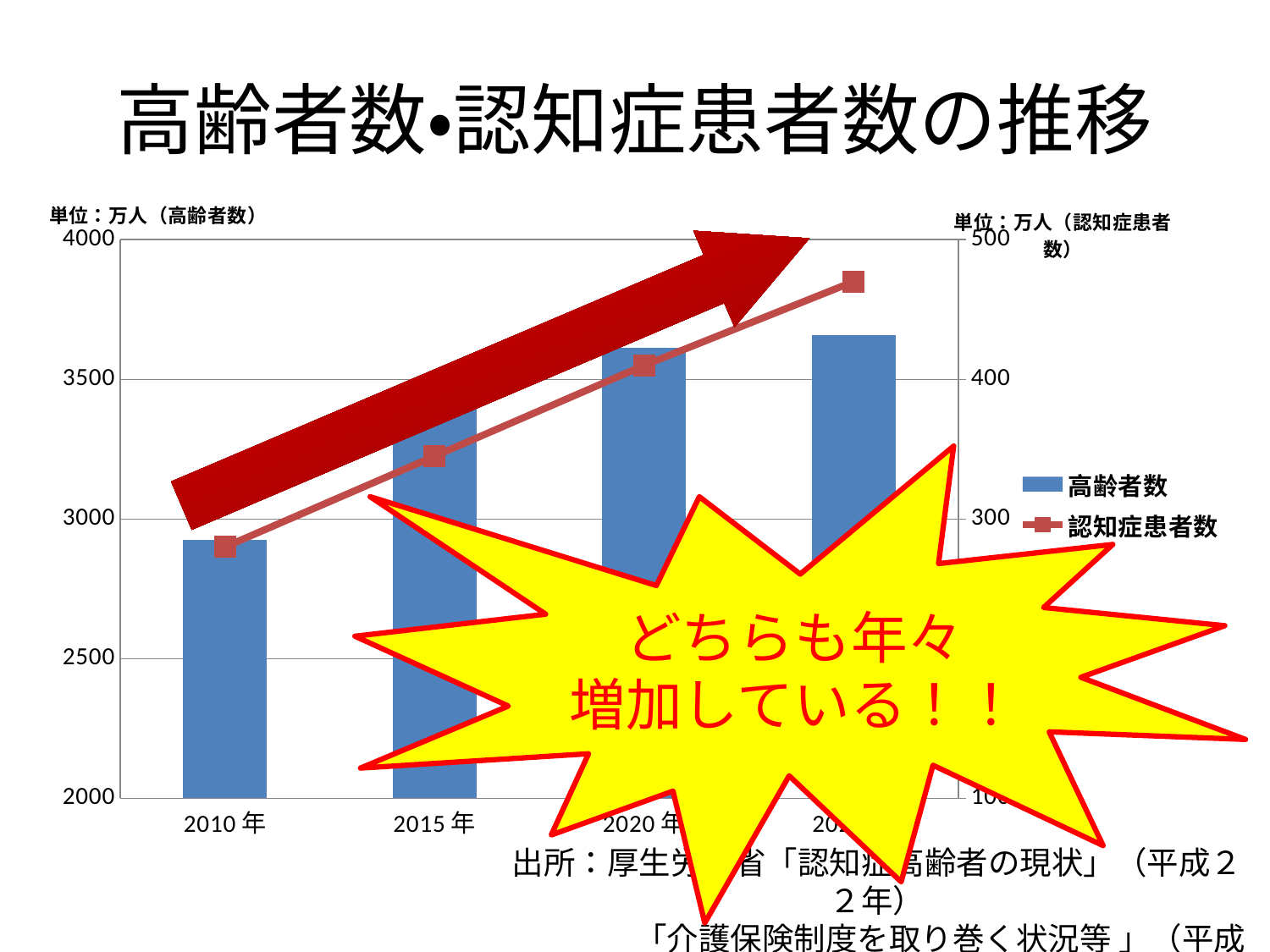
How many bars are plotted in the chart? 4 Is the 認知症患者数 value for 2010年 greater or less than 300 on the right axis? less Is the 認知症患者数 value for 2015年 greater or less than 300 on the right axis? greater What are the two series named in the legend? 高齢者数 and 認知症患者数 Is the 高齢者数 value for 2020年 greater or less than 3500? greater How many series does the legend list? 2 What is the title of the chart on the slide? 高齢者数•認知症患者数の推移 Do the 認知症患者数 values rise or fall from 2010年 onward along the x axis? rise Which year has the lowest 高齢者数 bar? 2010年 What kind of chart is shown on the slide? A combined bar and line chart